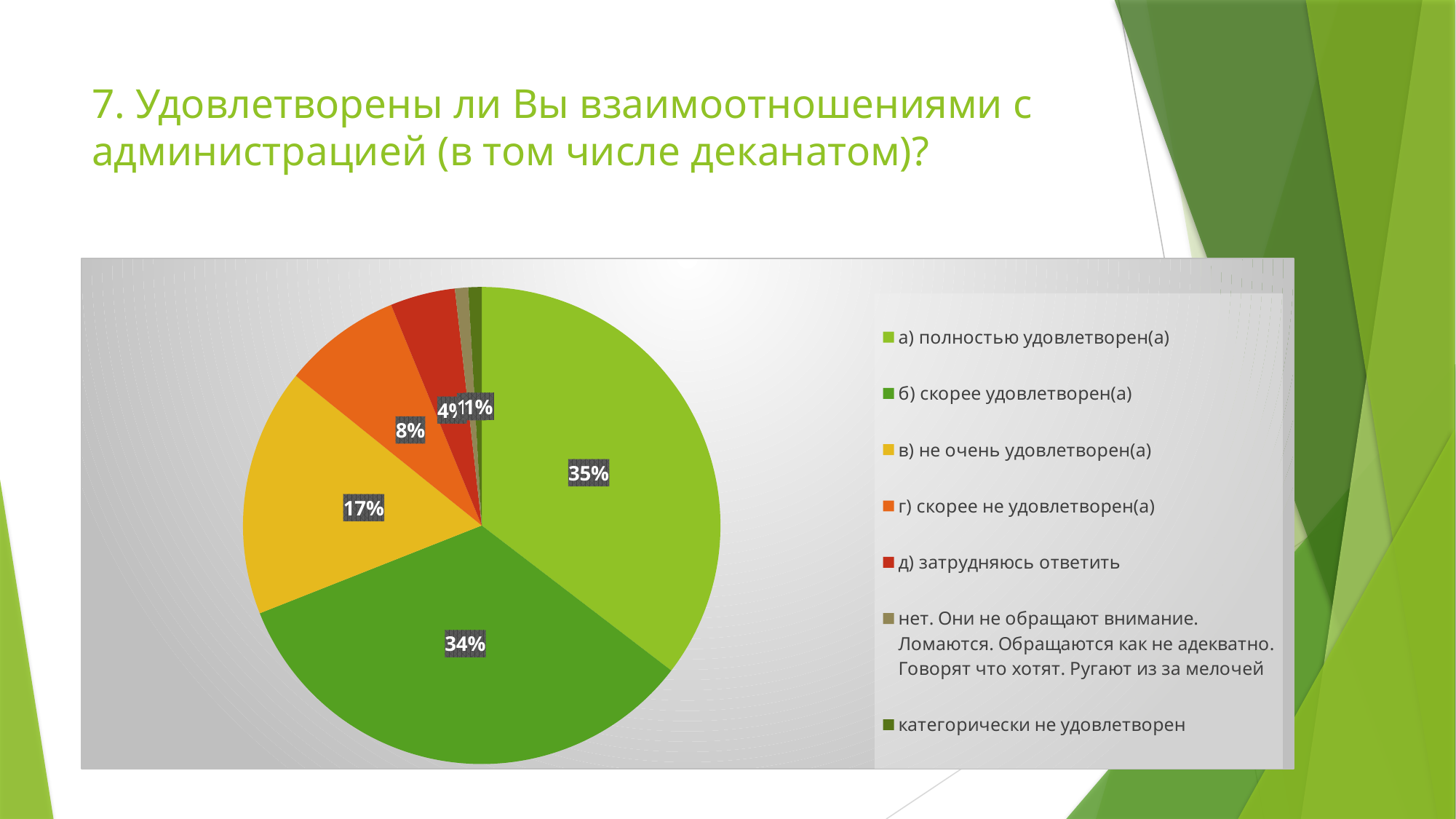
How many categories does the legend of the pie chart list? 7 Which is larger: the share for "б) скорее удовлетворен(а)" or the share for "в) не очень удовлетворен(а)"? б) скорее удовлетворен(а) What colour is the slice for "в) не очень удовлетворен(а)"? yellow What percentage of respondents answered "д) затрудняюсь ответить"? 4% What is the difference between the shares for "в) не очень удовлетворен(а)" and "г) скорее не удовлетворен(а)"? 9 percentage points What percentage of respondents answered "в) не очень удовлетворен(а)"? 17% What is the combined share of "а) полностью удовлетворен(а)" and "б) скорее удовлетворен(а)"? 69% Which answer option has the largest share of the pie? а) полностью удовлетворен(а) What percentage of respondents answered "а) полностью удовлетворен(а)"? 35% What type of chart is shown on the slide? pie chart What percentage of respondents answered "б) скорее удовлетворен(а)"? 34% What percentage of respondents answered "г) скорее не удовлетворен(а)"? 8%